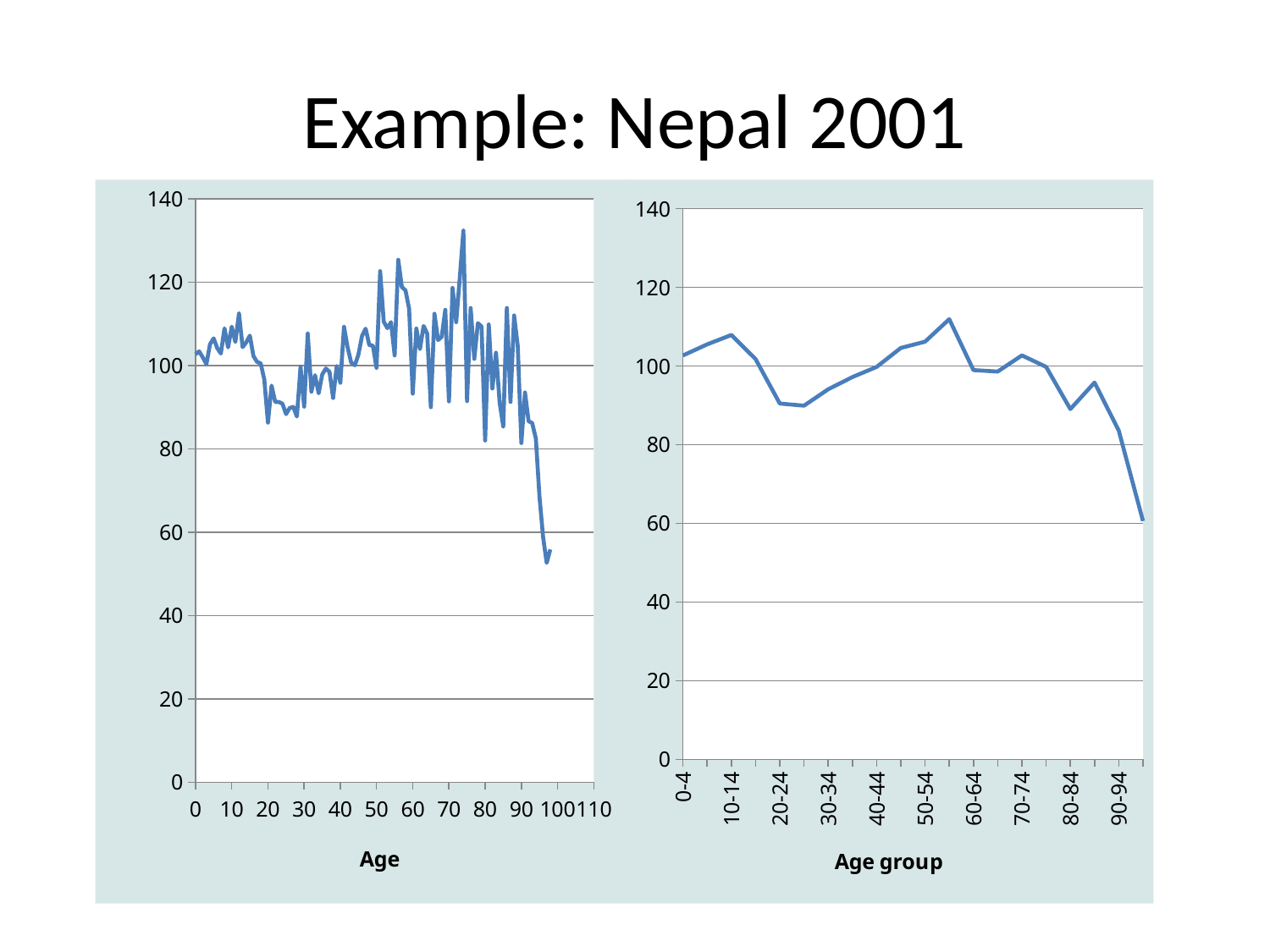
On the right chart, does the line rise or fall from the 80-84 age group to the last age group? fall On the right chart, is the value for the 80-84 age group greater or less than 100? less On the right chart, which age group has the larger value, 20-24 or 50-54? 50-54 What kind of chart is the right chart on the slide? line chart On the left chart, is the value at age 20 greater or less than 100? less What is the x-axis title of the right chart? Age group On the right chart, which age group has the larger value, 0-4 or 90-94? 0-4 On the right chart, is the value for the 30-34 age group greater or less than 100? less What kind of chart is the left chart on the slide? line chart What is the x-axis title of the left chart? Age